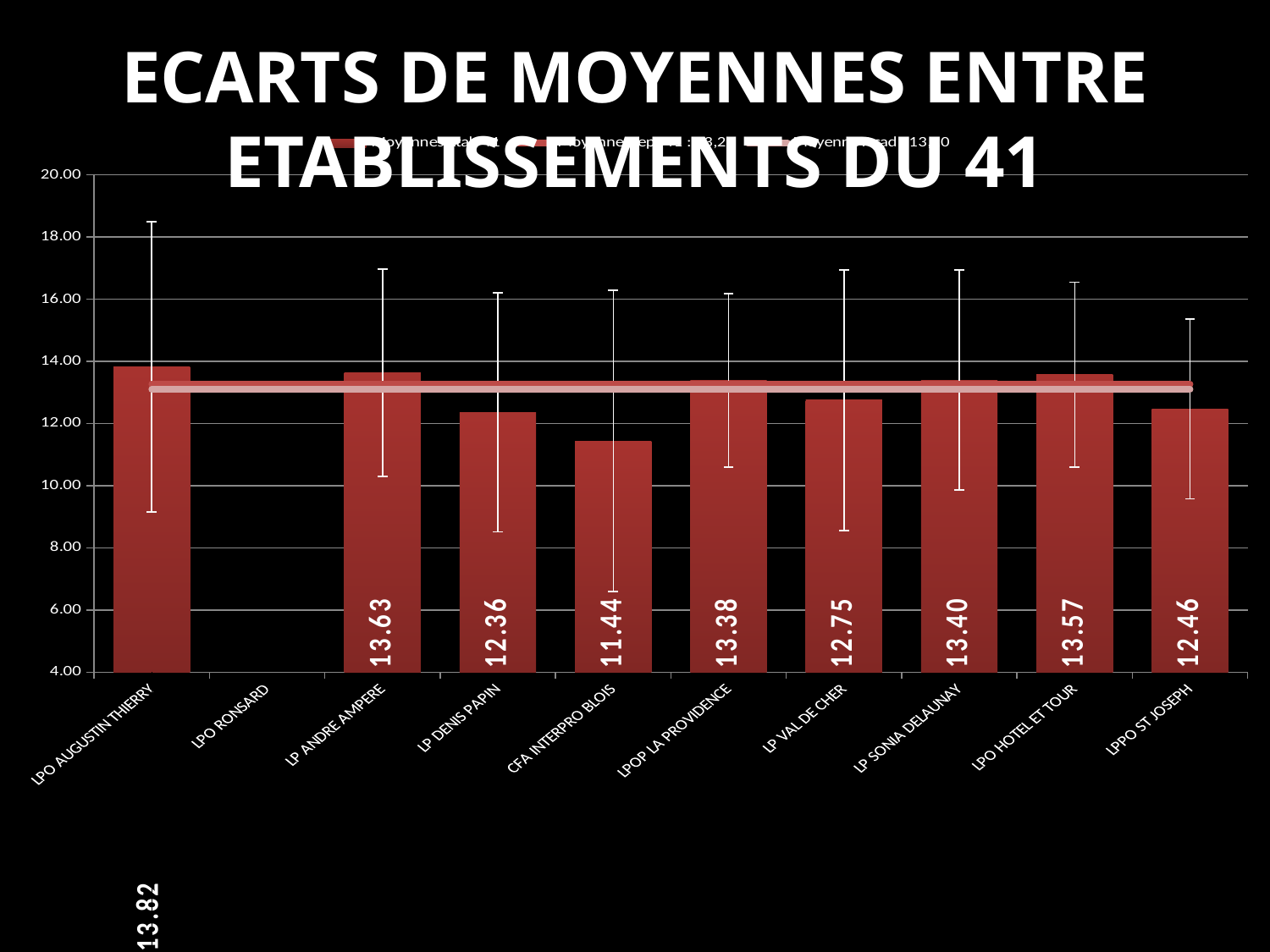
Which is larger, the value for LP VAL DE CHER or the value for LP DENIS PAPIN? LP VAL DE CHER Which establishment has the highest value? LPO AUGUSTIN THIERRY What is the value shown for LP ANDRE AMPERE? 13.63 What is the value shown for LPO HOTEL ET TOUR? 13.57 How many establishments are labelled on the x axis? 10 What kind of chart is shown on the slide? combination bar and line chart What is the difference between the values for LPO AUGUSTIN THIERRY and CFA INTERPRO BLOIS? 2.38 Is the value for CFA INTERPRO BLOIS greater or less than 12.00? less What is the value shown for LPPO ST JOSEPH? 12.46 What is the value shown for CFA INTERPRO BLOIS? 11.44 What is the difference between the values for LP ANDRE AMPERE and LP DENIS PAPIN? 1.27